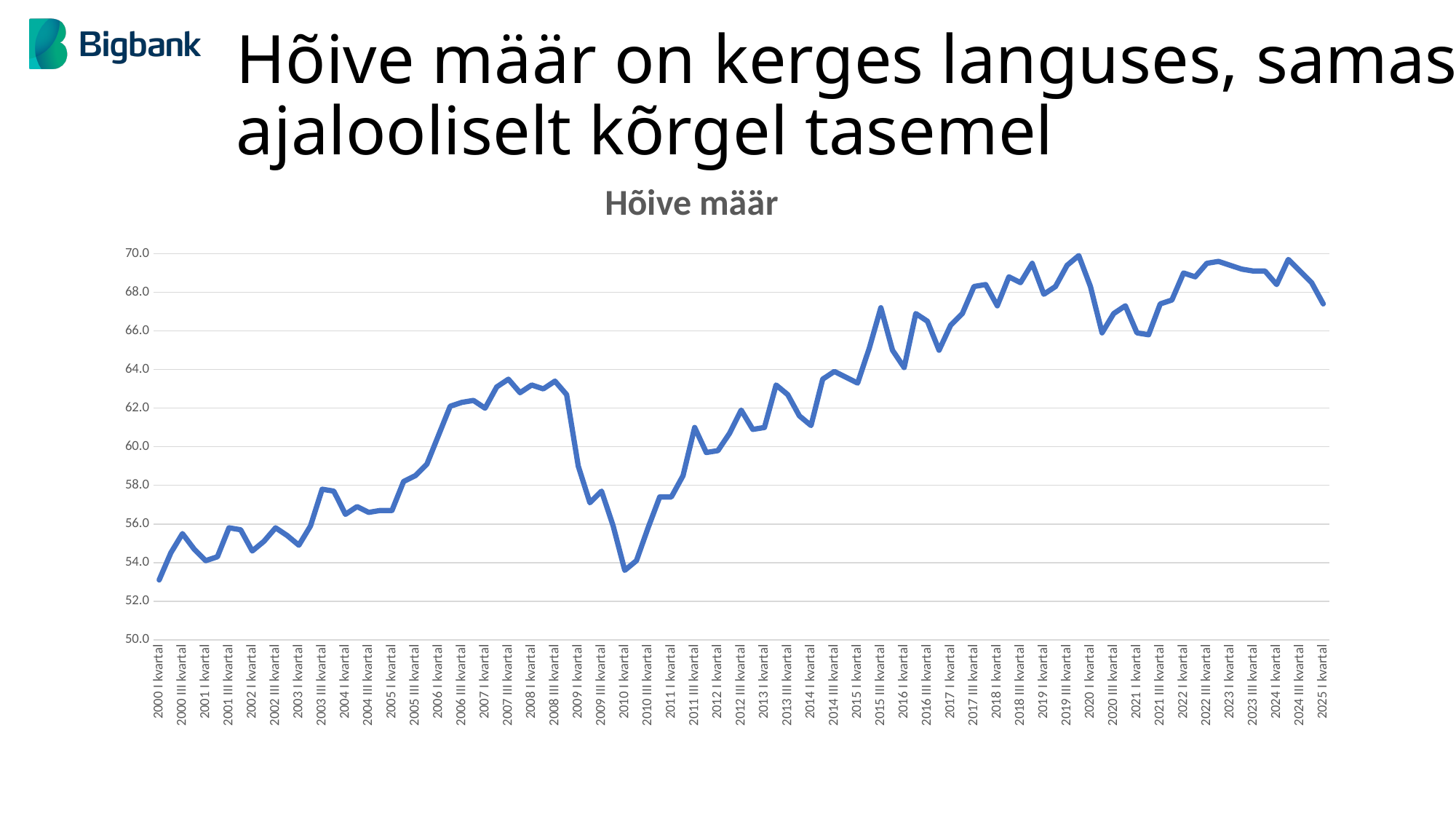
Is the value for 2025 I kvartal greater or less than 66.0? greater What kind of chart is shown on the slide? line chart What is the title of the chart? Hõive määr Is the value for 2009 III kvartal greater or less than 58.0? less Which is larger, the value for 2008 III kvartal or the value for 2010 I kvartal? 2008 III kvartal Do the values rise or fall between 2024 I kvartal and 2025 I kvartal? fall How many data series are plotted in the chart? 1 Is the value for 2000 I kvartal greater or less than 54.0? less What is the highest value shown on the y axis of the chart? 70.0 Which is larger, the value for 2025 I kvartal or the value for 2000 I kvartal? 2025 I kvartal